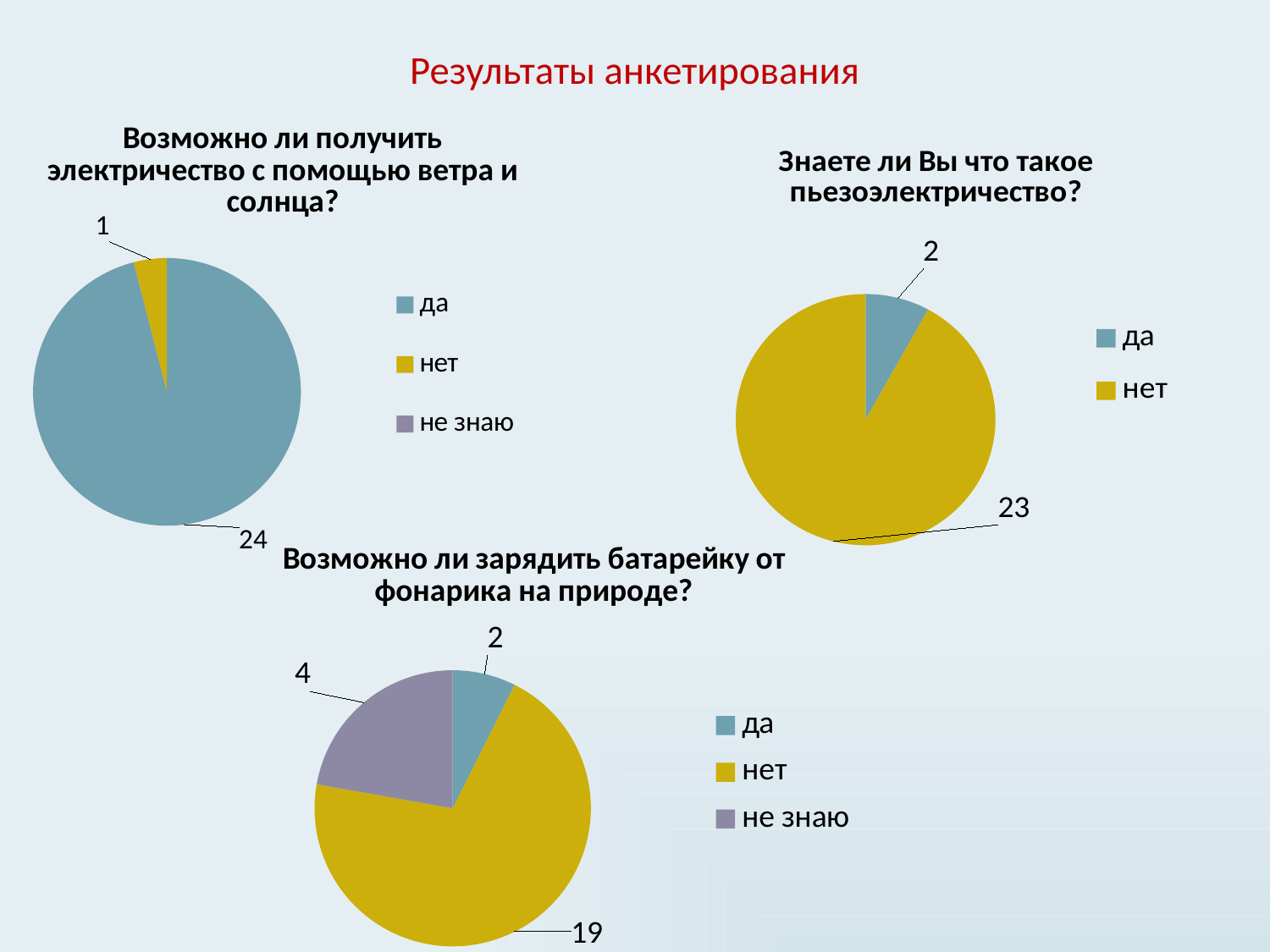
What kind of chart is the chart titled "Знаете ли Вы что такое пьезоэлектричество?"? Pie chart In the chart titled "Знаете ли Вы что такое пьезоэлектричество?", which category has the smallest slice? да In the chart titled "Возможно ли получить электричество с помощью ветра и солнца?", what is the value for "да"? 24 How many charts are shown on the slide? 3 In the chart titled "Возможно ли зарядить батарейку от фонарика на природе?", which is larger, "да" or "не знаю"? не знаю In the chart titled "Возможно ли получить электричество с помощью ветра и солнца?", what is the value for "нет"? 1 In the chart titled "Знаете ли Вы что такое пьезоэлектричество?", what is the value for "нет"? 23 In the chart titled "Возможно ли зарядить батарейку от фонарика на природе?", how many entries does the legend list? 3 In the chart titled "Знаете ли Вы что такое пьезоэлектричество?", what is the difference between "нет" and "да"? 21 In the chart titled "Возможно ли зарядить батарейку от фонарика на природе?", what is the value for "не знаю"? 4 In the chart titled "Возможно ли зарядить батарейку от фонарика на природе?", which category has the largest slice? нет